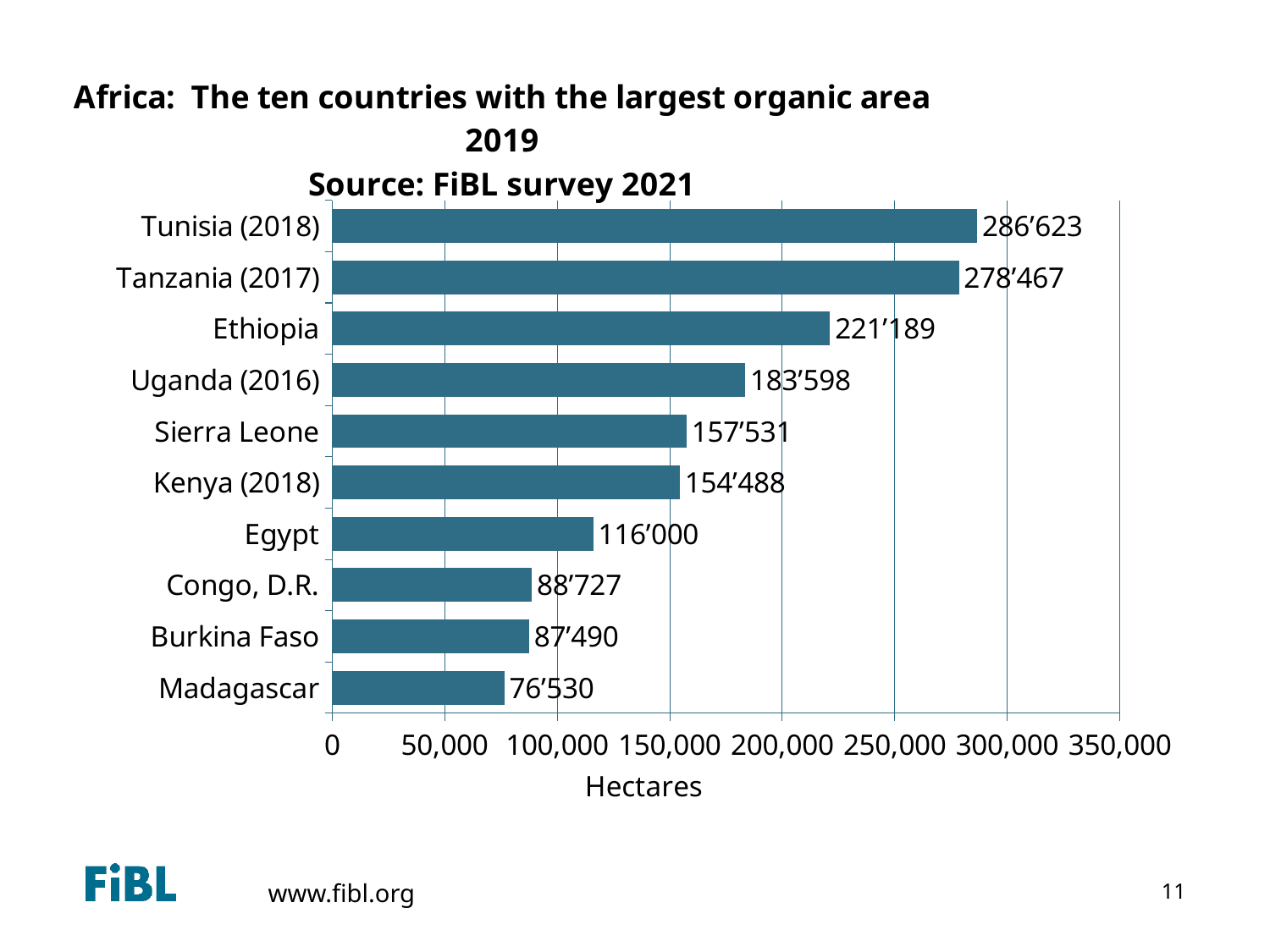
Which country has the largest organic area? Tunisia (2018) Is the value for Kenya (2018) greater or less than 150,000? greater What is the organic area in hectares for Madagascar? 76'530 How many countries are shown in the chart? 10 What kind of chart is shown on the slide? Bar chart What is the difference in hectares between Tunisia (2018) and Tanzania (2017)? 8'156 What is the organic area in hectares for Ethiopia? 221'189 What is the organic area in hectares for Egypt? 116'000 Which has a larger organic area, Congo, D.R. or Burkina Faso? Congo, D.R. What is the difference in hectares between Uganda (2016) and Sierra Leone? 26'067 Which country has the smallest organic area among the ten shown? Madagascar What is the label of the horizontal axis? Hectares